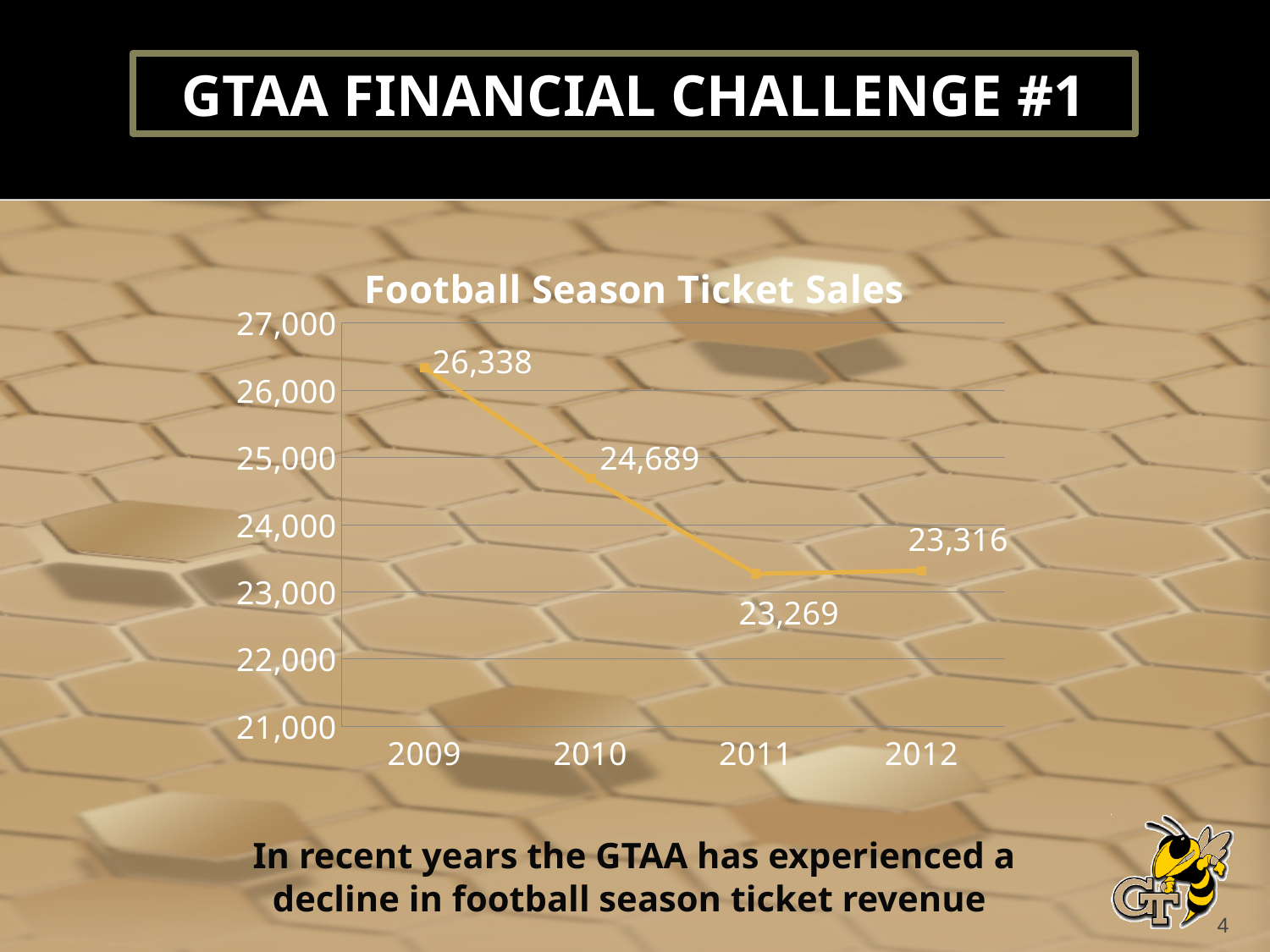
What is the value for 2009 in the Football Season Ticket Sales chart? 26,338 Which year has the lowest football season ticket sales? 2011 Is the value for 2010 greater or less than 25,000? less How many years are plotted in the chart? 4 Which year has the highest football season ticket sales? 2009 Which year has the larger value, 2010 or 2011? 2010 What is the difference between the 2009 and 2010 values? 1,649 What is the value for 2011 in the Football Season Ticket Sales chart? 23,269 What kind of chart is shown on the slide? line chart What is the value for 2010 in the Football Season Ticket Sales chart? 24,689 What is the value for 2012 in the Football Season Ticket Sales chart? 23,316 What is the difference between the 2009 and 2012 values? 3,022